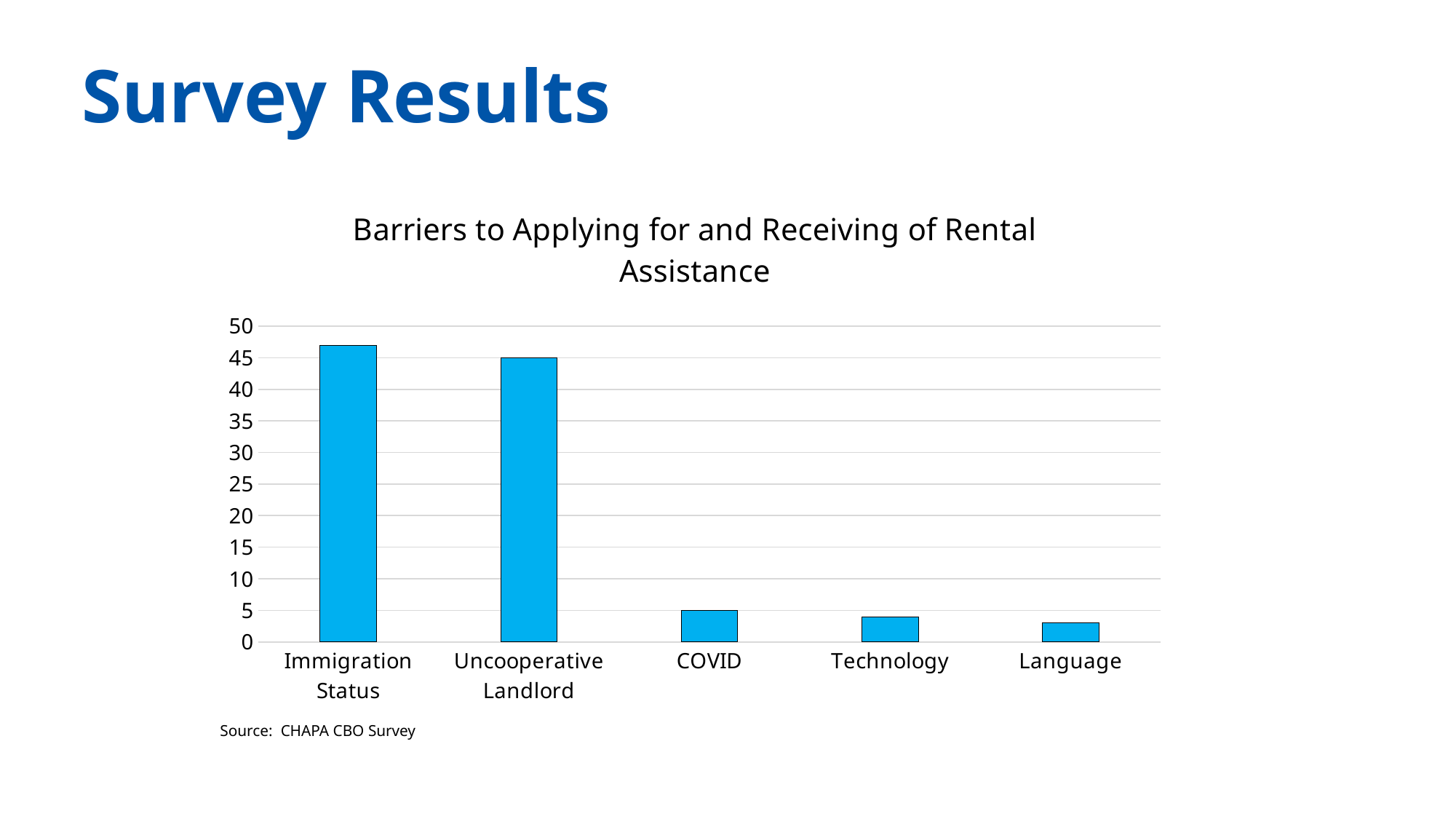
What is the title of the chart? Barriers to Applying for and Receiving of Rental Assistance What kind of chart is shown on the slide? bar chart Is the value for Language greater or less than 10? less What is the value for COVID? 5 Which barrier has the highest value? Immigration Status What is the value for Uncooperative Landlord? 45 Which is larger, the value for COVID or the value for Uncooperative Landlord? Uncooperative Landlord How many barrier categories are shown on the x axis? 5 What source is cited below the chart? CHAPA CBO Survey Which is larger, the value for Immigration Status or the value for Uncooperative Landlord? Immigration Status Is the value for Technology greater or less than 5? less Is the value for Immigration Status greater or less than 45? greater